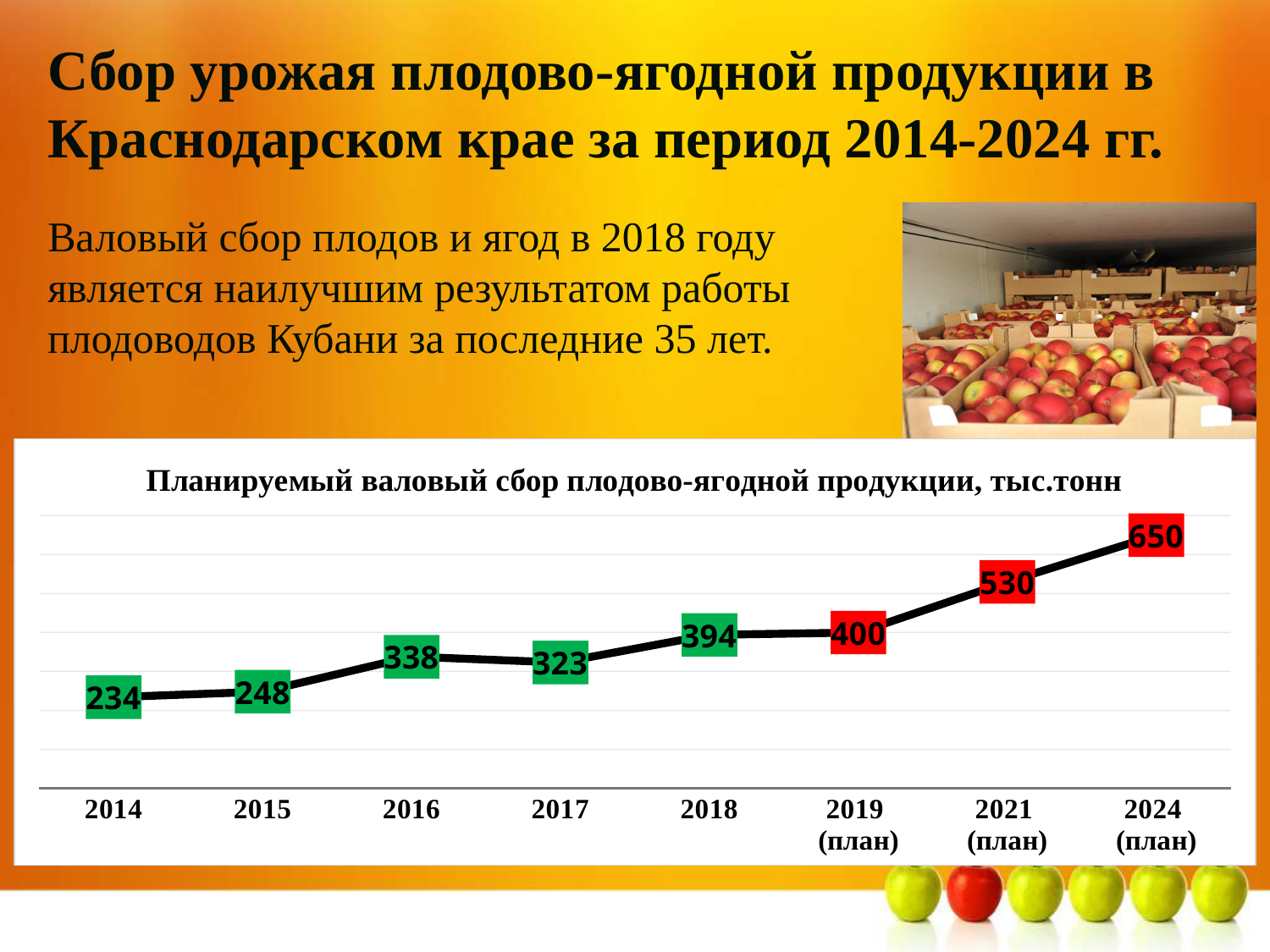
What is the planned value for 2024 (план)? 650 What is the difference between the values for 2016 and 2017? 15 How many data points are plotted on the chart? 8 What is the value for 2014 on the chart? 234 What kind of chart is shown on the slide? line chart Do the values generally rise or fall from 2014 to 2024 (план)? rise What is the title of the chart? Планируемый валовый сбор плодово-ягодной продукции, тыс.тонн What is the difference between the values for 2024 (план) and 2021 (план)? 120 What is the value for 2018 on the chart? 394 Which is larger, the value for 2016 or the value for 2017? 2016 Which year has the highest value on the chart? 2024 (план) Which year has the lowest value on the chart? 2014